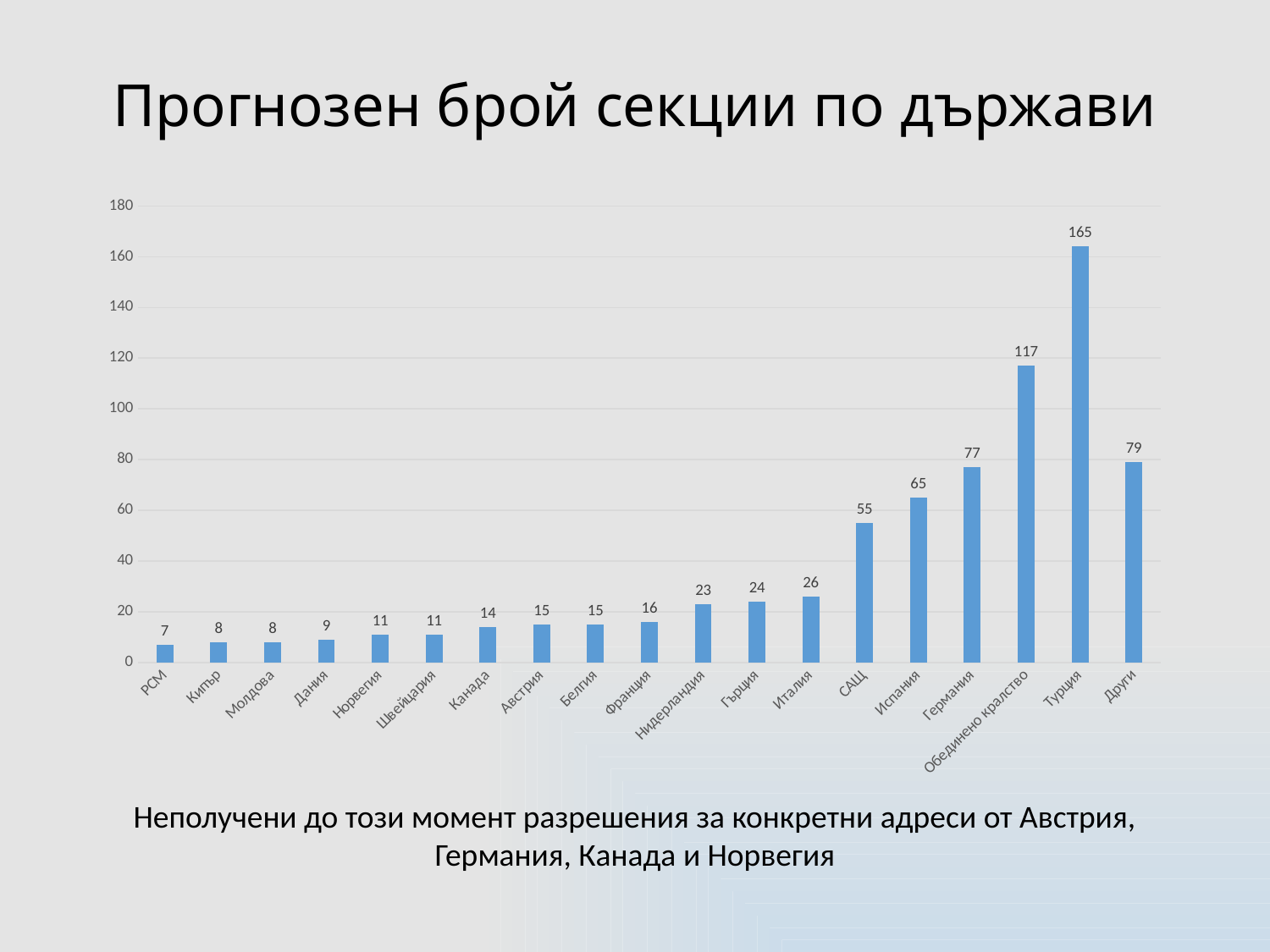
Do the values generally rise or fall from left to right along the x axis? rise What is the value for Обединено кралство? 117 What kind of chart is shown on the slide? bar chart What is the difference between the values for Турция and Обединено кралство? 48 What is the value for Испания? 65 Which category has the lowest value? РСМ What is the value for Турция? 165 Which category has the highest value? Турция Is the value for САЩ greater or less than 60? less What is the title of the slide? Прогнозен брой секции по държави How many categories are shown on the x axis? 19 Which is larger, the value for Германия or the value for Други? Други